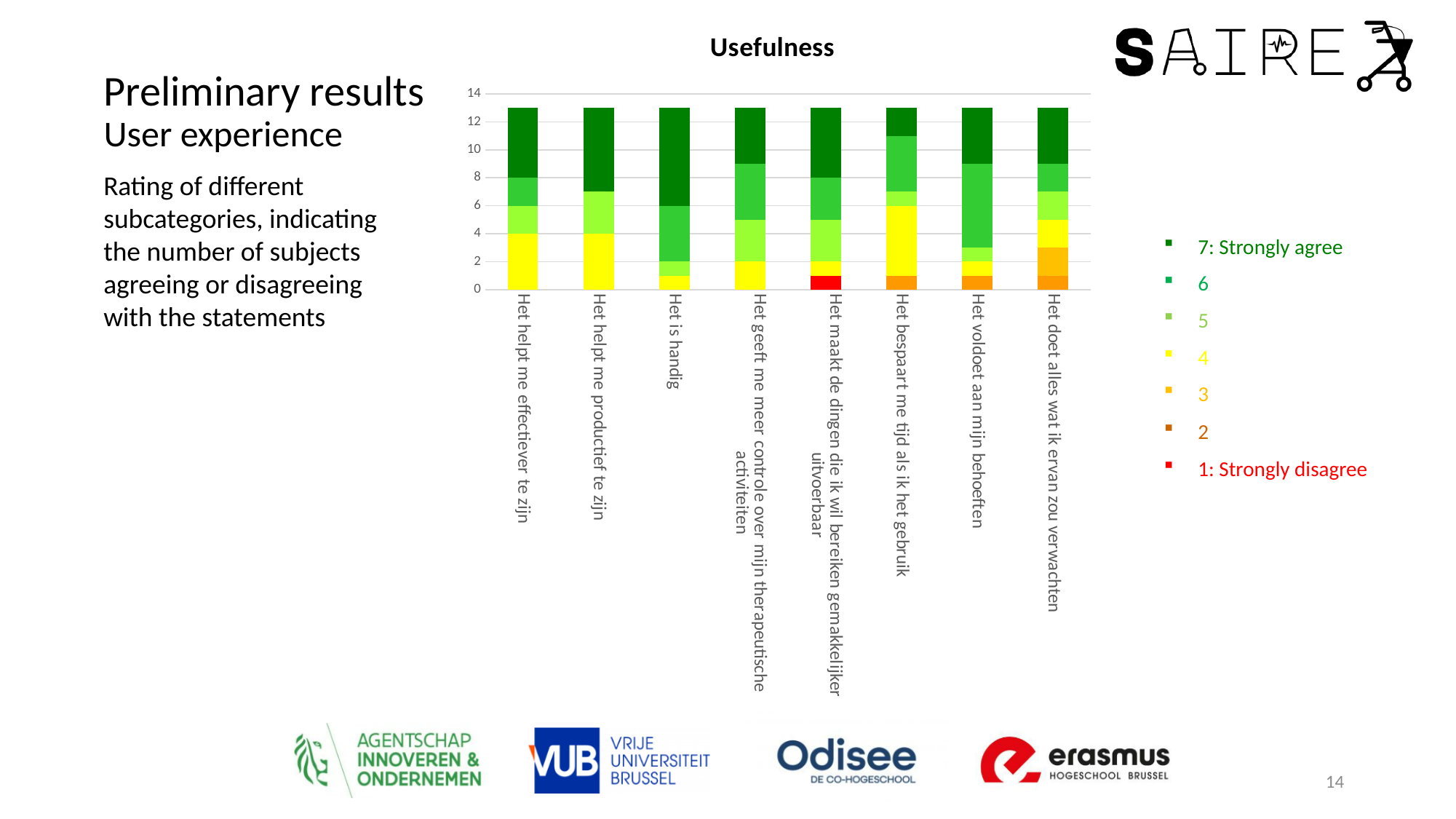
Which statement has the smallest '7: Strongly agree' segment? Het bespaart me tijd als ik het gebruik Is the total bar height for 'Het is handig' greater or less than 12? greater How many rating levels does the legend list? 7 Which statement is the only one with a '1: Strongly disagree' segment? Het maakt de dingen die ik wil bereiken gemakkelijker uitvoerbaar What is the title of the chart? Usefulness Is the total bar height for 'Het helpt me productief te zijn' greater or less than 14? less Which statement has a larger '7: Strongly agree' segment, 'Het is handig' or 'Het bespaart me tijd als ik het gebruik'? Het is handig What kind of chart is shown on the slide? Stacked bar chart Which colour represents '1: Strongly disagree' in the legend? Red Is the '4' (yellow) segment for 'Het helpt me effectiever te zijn' greater or less than 2? greater How many statements (categories) are shown on the x axis of the chart? 8 Which statement has the largest '3' (orange) segment? Het doet alles wat ik ervan zou verwachten